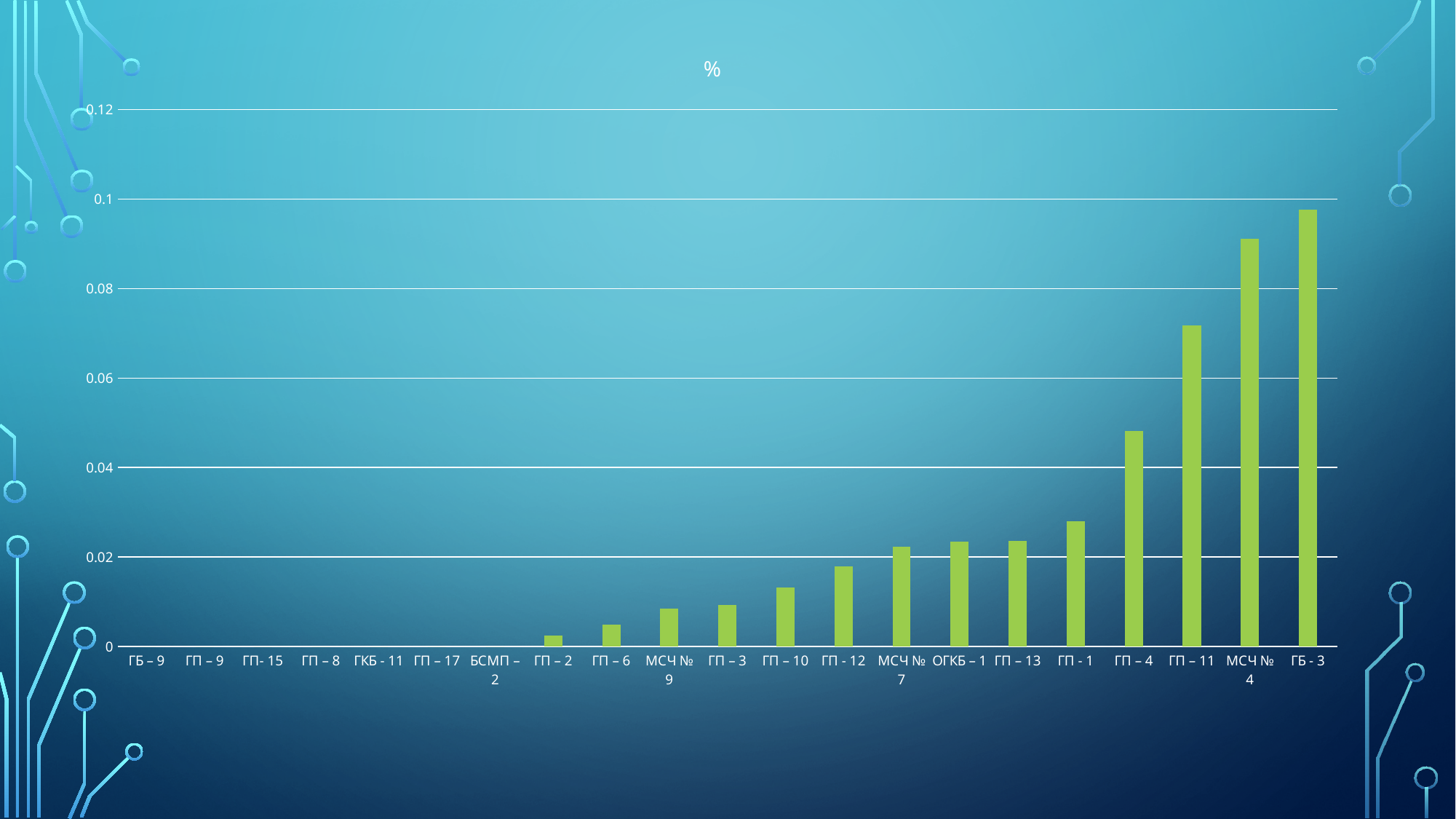
How many categories are shown on the x axis of the chart? 21 Do the values generally rise or fall from left to right along the x axis? rise How many categories on the x axis have no visible bar (a value of zero)? 7 Is the value for ГП – 11 greater or less than 0.08? less Is the value for ГБ - 3 greater or less than 0.08? greater What is the title of the chart? % What kind of chart is shown on the slide? bar chart Is the value for ГП - 12 greater or less than 0.02? less Which is larger, the value for МСЧ № 4 or the value for ГП – 11? МСЧ № 4 Which category has the highest value in the chart? ГБ - 3